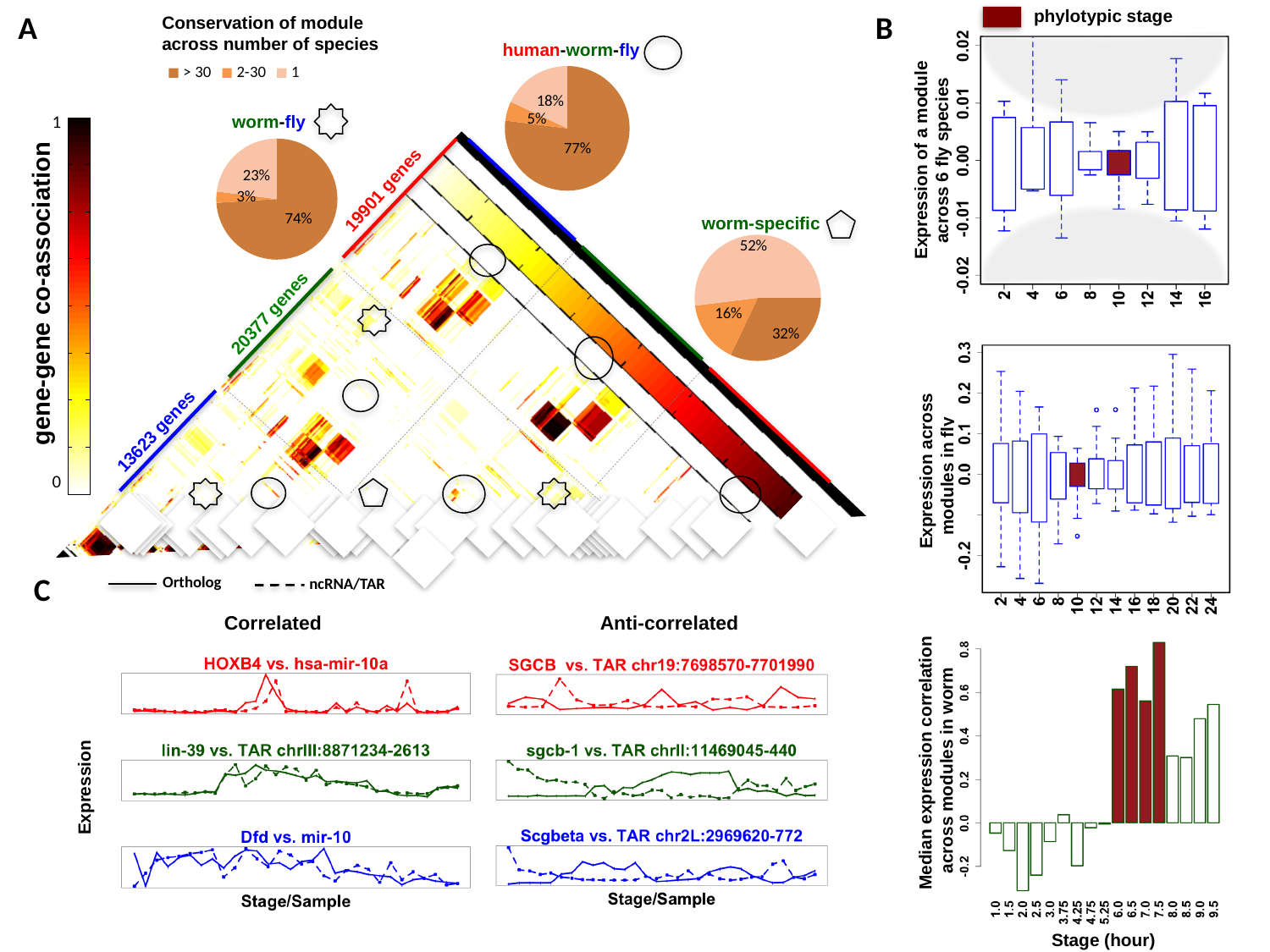
In the human-worm-fly pie chart, which conservation category has the largest slice? > 30 In the worm-specific pie chart, which conservation category has the largest slice? 1 How many percentage points larger is the > 30 slice in the human-worm-fly pie chart than the > 30 slice in the worm-fly pie chart? 3 What kind of chart is the bottom chart in panel B (median expression correlation across modules in worm)? bar chart In panel C, what does the dashed line represent according to the legend? ncRNA/TAR In the bottom chart of panel B, how many stage (hour) categories are shown on the x axis? 17 In the worm-specific pie chart, what percentage is shown for the 2-30 species category? 16% In the worm-fly pie chart, what percentage of modules are conserved across more than 30 species? 74% How many conservation categories does the pie chart legend list? 3 Which pie chart has the larger slice for modules conserved in only 1 species: worm-fly or human-worm-fly? worm-fly In the bottom chart of panel B, is the value for stage 9.5 hours greater or less than 0.4? greater